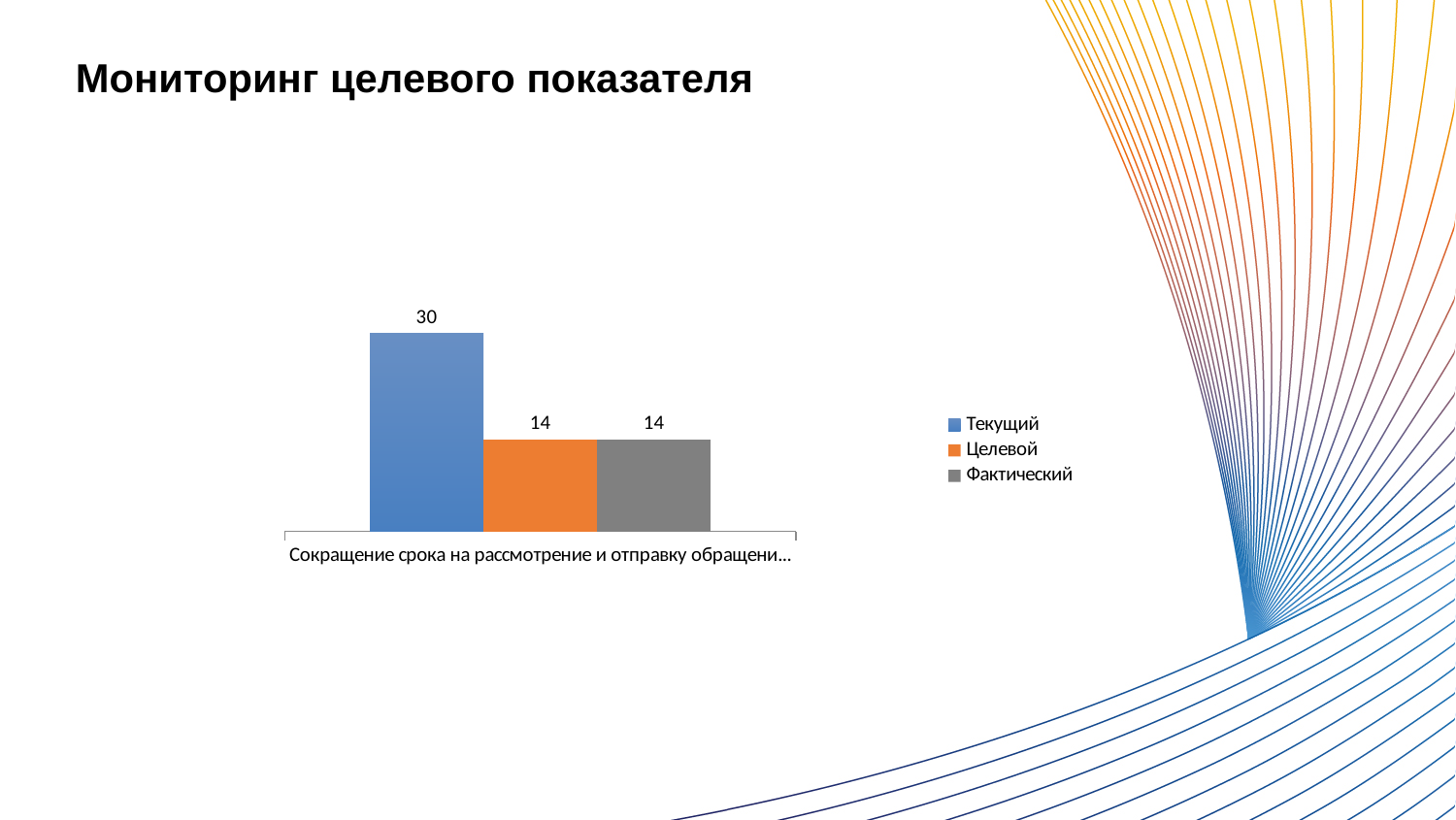
Which series has the highest value in the bar chart? Текущий What is the difference between the Текущий value and the Целевой value? 16 Which series is shown in orange in the legend? Целевой Which is larger, the Целевой value or the Текущий value? Текущий What is the value of the Текущий series in the bar chart? 30 What is the difference between the Текущий value and the Фактический value? 16 What is the value of the Целевой series in the bar chart? 14 How many categories are shown on the x axis of the chart? 1 What is the value of the Фактический series in the bar chart? 14 What kind of chart is shown on the slide? Bar chart How many series does the legend list? 3 Which is larger, the Текущий value or the Фактический value? Текущий